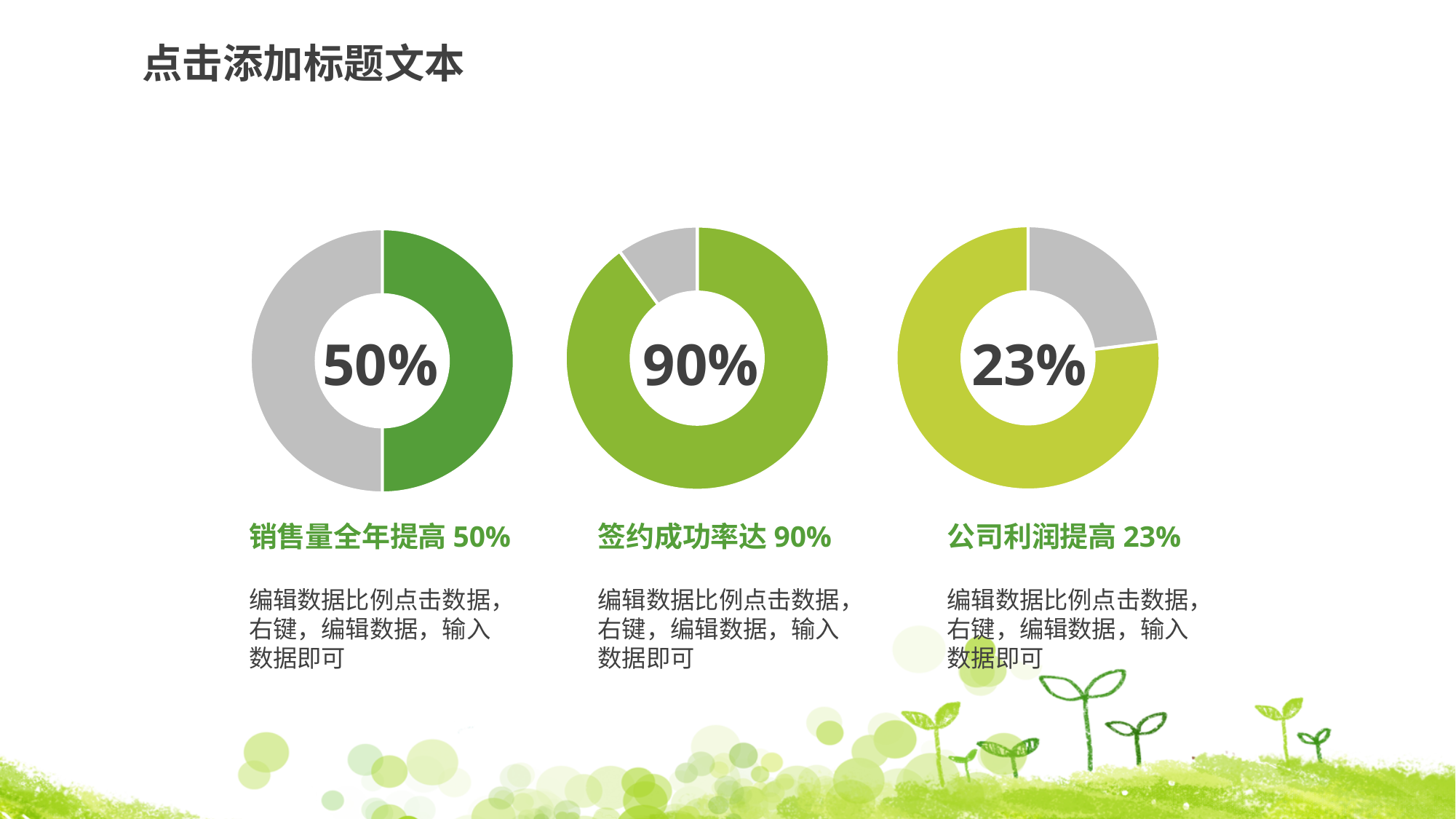
What is the caption under the right donut chart? 公司利润提高 23% What is the difference between the percentage in the middle donut chart and the percentage in the right donut chart? 67% How many donut charts are on the slide? 3 Which of the three donut charts shows the lowest percentage? The right chart (23%) What is the difference between the percentage in the left donut chart and the percentage in the right donut chart? 27% What value is shown in the centre of the right donut chart? 23% Which of the three donut charts shows the highest percentage? The middle chart (90%) What kind of chart is used to show the 50%, 90% and 23% values? Donut (pie) chart What value is shown in the centre of the left donut chart? 50% What value is shown in the centre of the middle donut chart? 90% Is the percentage in the left donut chart larger or smaller than the percentage in the middle donut chart? Smaller What share of the left donut chart is filled with green? 50%